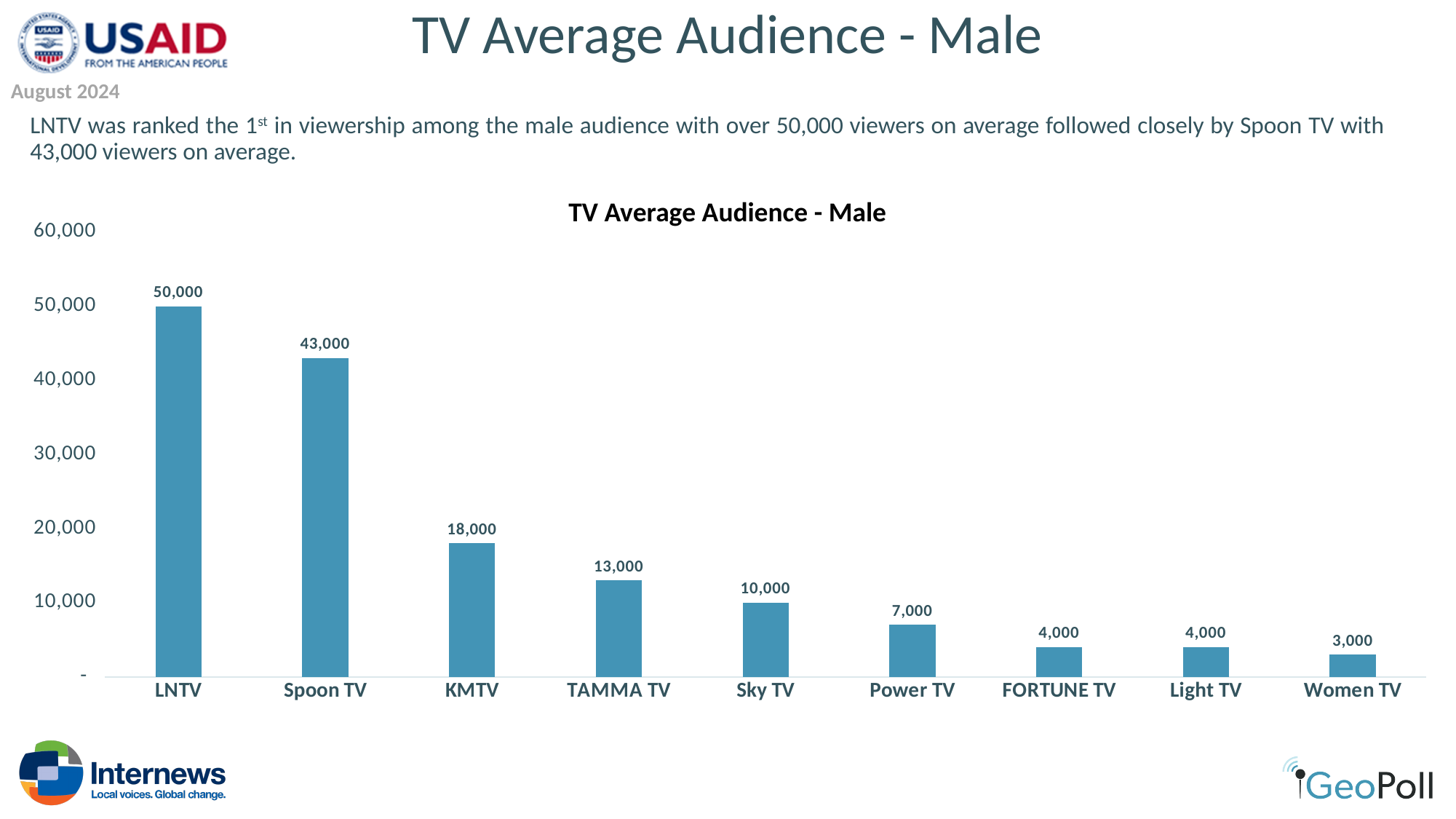
Which has a larger average male audience, KMTV or Sky TV? KMTV Which TV station has the highest average male audience? LNTV What is the title of the chart? TV Average Audience - Male Which TV station has the lowest average male audience? Women TV What is the average male audience for LNTV? 50,000 What is the difference between the average male audience of LNTV and Spoon TV? 7,000 How many TV stations are shown in the chart? 9 What is the average male audience for KMTV? 18,000 Is the value for Spoon TV greater or less than 40,000? greater What kind of chart is shown on the slide? Bar chart What is the average male audience for Power TV? 7,000 What is the difference between the average male audience of TAMMA TV and Sky TV? 3,000